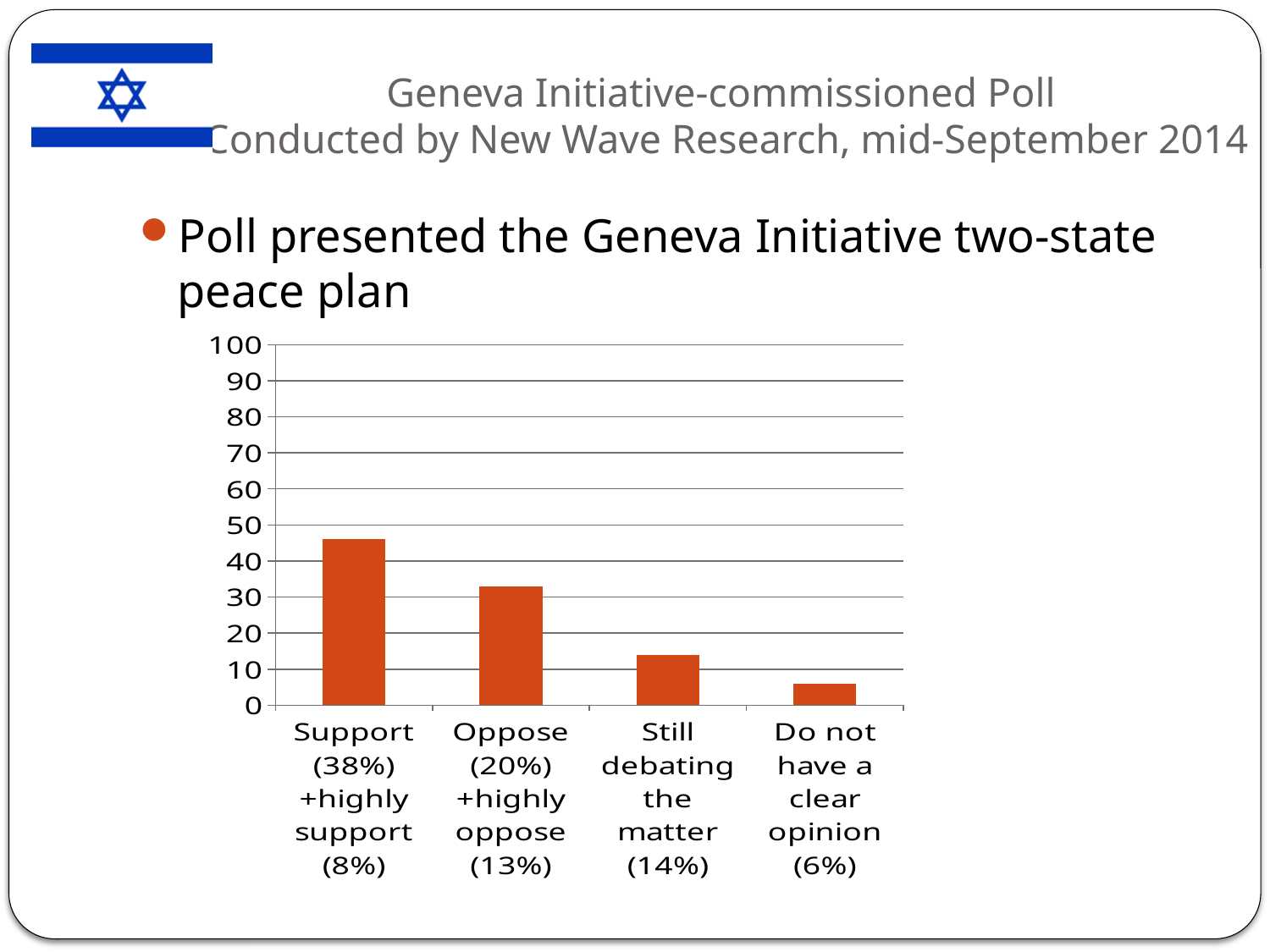
What percentage is printed in the category label for 'Still debating the matter'? 14% Is the value for Still debating the matter greater or less than 20? less Which category has the tallest bar? Support (38%) +highly support (8%) Is the value for Support +highly support greater or less than 40? greater Is the value for Do not have a clear opinion greater or less than 10? less Which bar is taller: Support +highly support or Oppose +highly oppose? Support +highly support What kind of chart is shown on the slide? bar chart How many categories are shown on the x axis of the chart? 4 Which category has the shortest bar? Do not have a clear opinion (6%) Do the bar values rise or fall from left to right across the x axis? fall What is the highest value shown on the y axis of the chart? 100